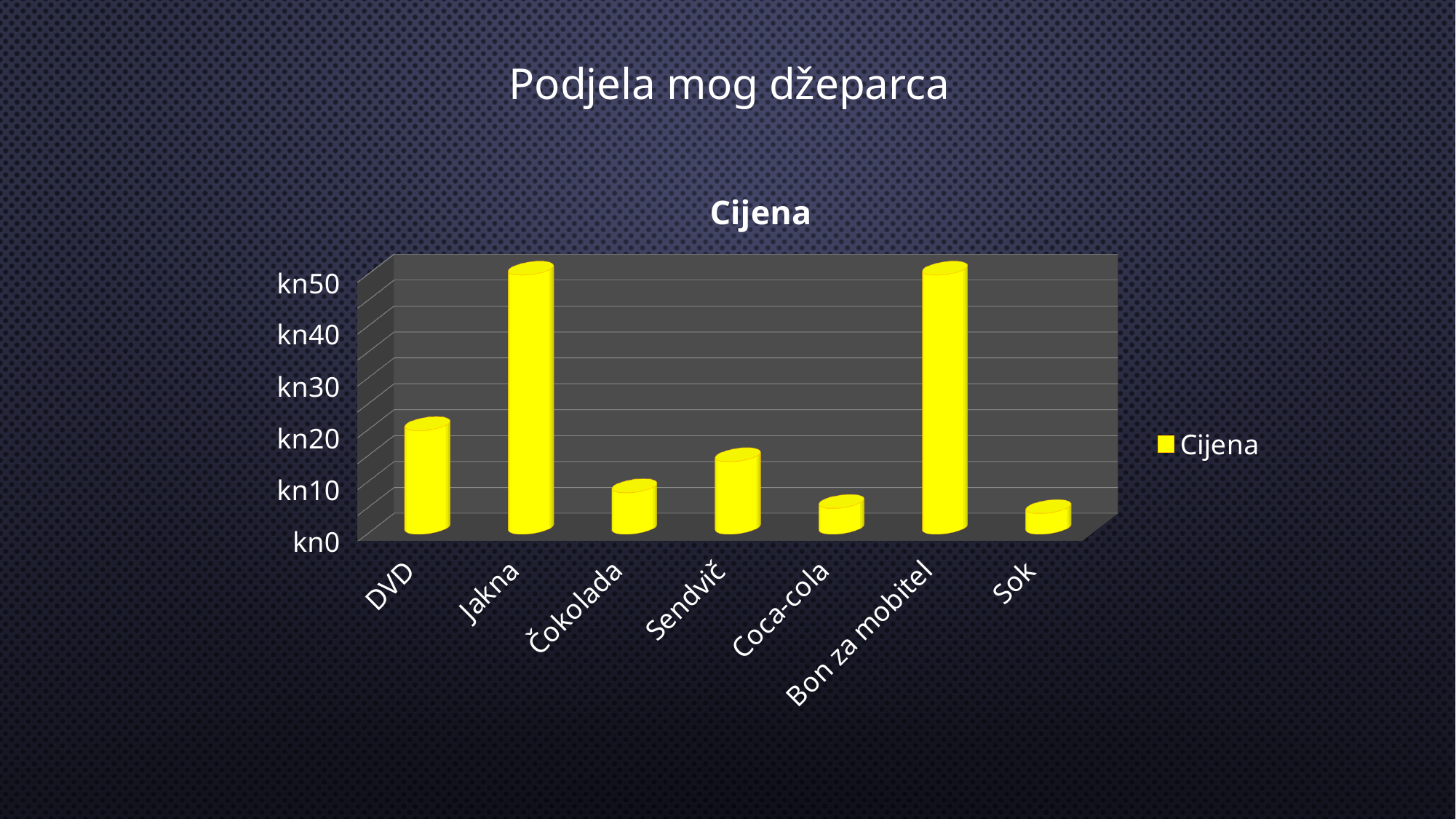
Is the value for Jakna greater or less than kn40? greater Is the value for Sok greater or less than kn10? less Which has the larger value, Jakna or DVD? Jakna What is the title of the chart? Cijena Is the value for DVD greater or less than kn10? greater What kind of chart is shown on the slide? Bar chart Which has the larger value, DVD or Sendvič? DVD What colour are the bars in the chart? Yellow How many categories are plotted on the x axis of the chart? 7 How many series does the chart's legend list? 1